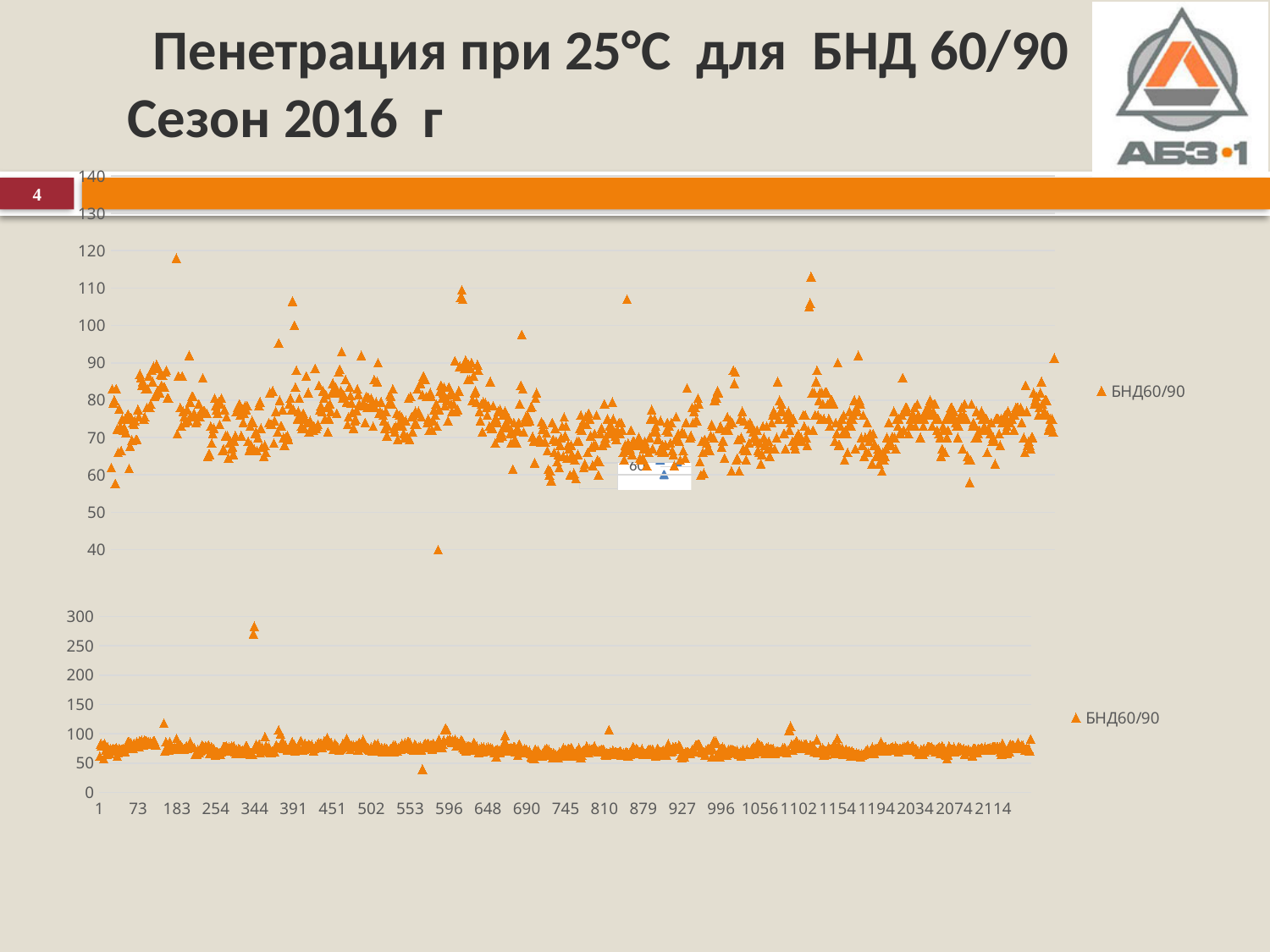
How many series does the legend of the bottom chart list? 1 How many series does the legend of the top chart list? 1 What is the highest value shown on the vertical axis of the bottom chart? 300 In the top chart, is the lowest plotted point greater or less than 50? less What kind of chart is the top chart on the slide? scatter chart In the bottom chart, is the highest plotted point greater or less than 250? greater In the bottom chart, is the lowest plotted point greater or less than 50? less What kind of chart is the bottom chart on the slide? scatter chart What is the series name shown in the legend of the top chart? БНД60/90